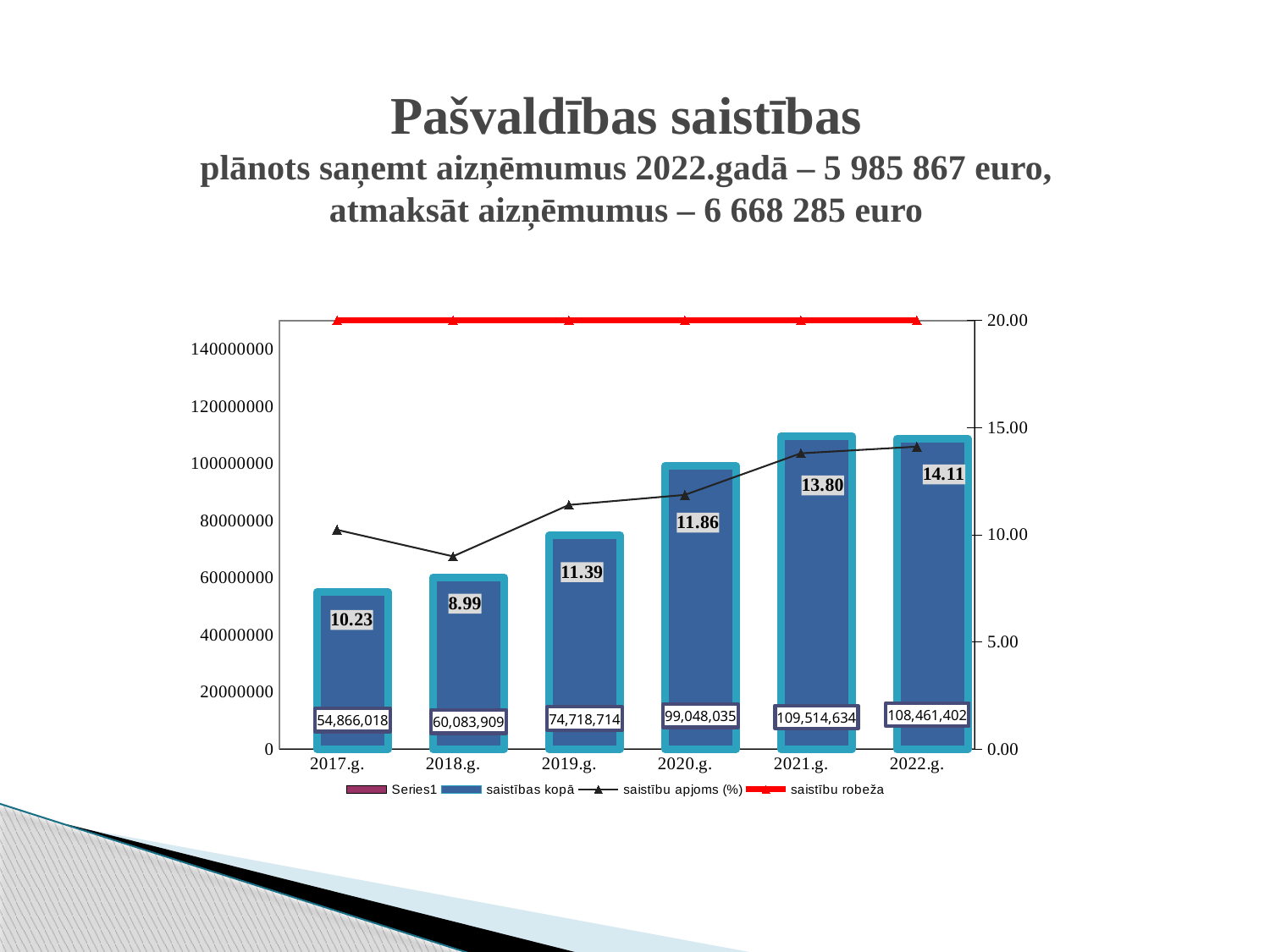
How many series does the legend list? 4 Which year has the highest 'saistības kopā' value? 2021.g. How many years are shown on the x axis? 6 At what value on the right axis does the red 'saistību robeža' line sit? 20.00 What is the 'saistību apjoms (%)' value for 2022.g.? 14.11 Which is larger, the 'saistību apjoms (%)' value for 2019.g. or for 2020.g.? 2020.g. Is the 'saistības kopā' value for 2019.g. greater or less than 80000000? less What is the value of 'saistības kopā' for 2020.g.? 99,048,035 Does the 'saistību apjoms (%)' line rise or fall from 2018.g. to 2022.g.? rise What is the 'saistību apjoms (%)' value for 2018.g.? 8.99 Which year has the lowest 'saistību apjoms (%)' value? 2018.g. What is the difference between the 'saistības kopā' values for 2021.g. and 2022.g.? 1,053,232